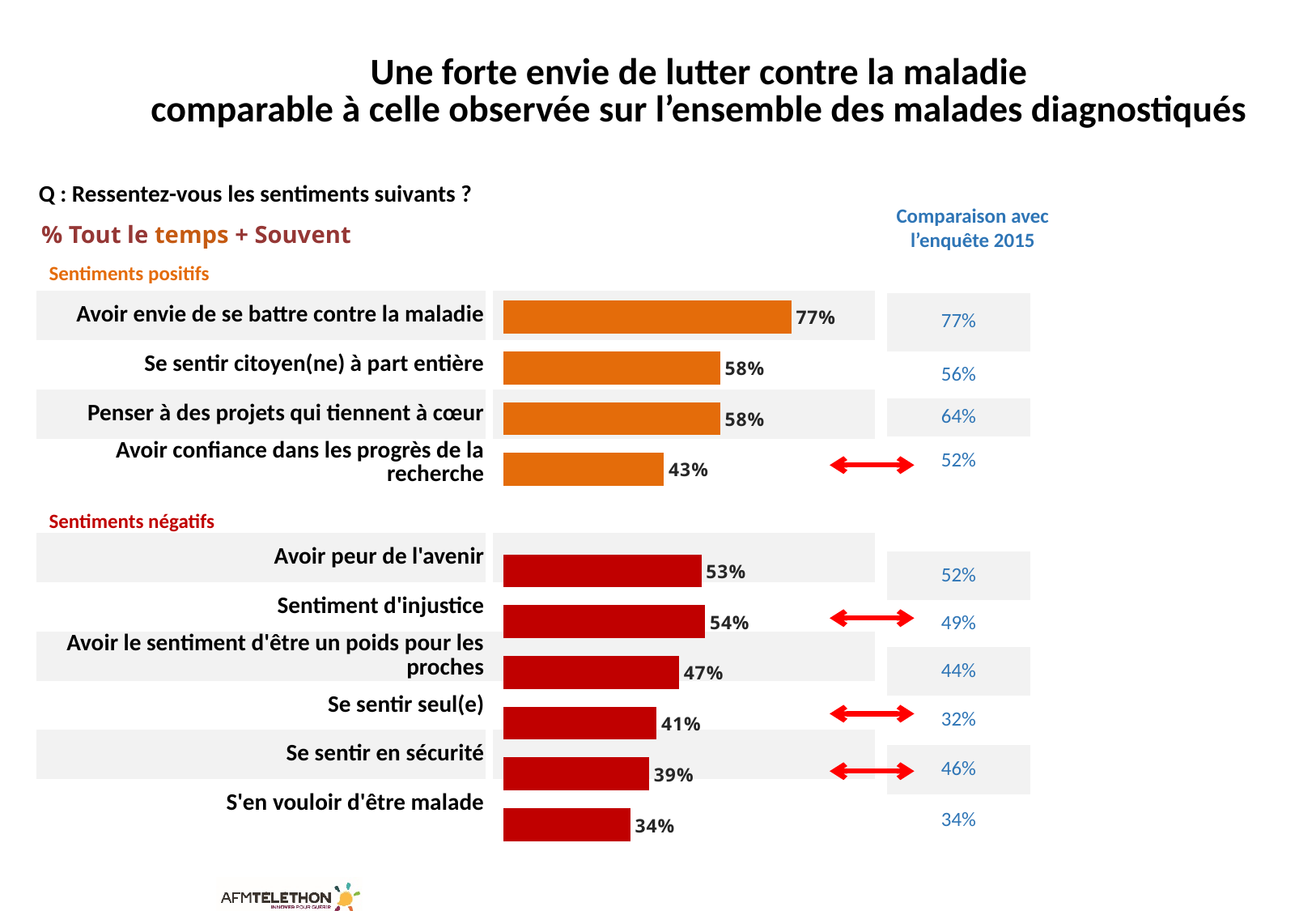
What is the difference between the percentage for "Se sentir en sécurité" and its 2015 comparison value? 7% Which category has the highest percentage in the bar chart? Avoir envie de se battre contre la maladie What colour are the bars for the "Sentiments négatifs" categories? Red What percentage is shown for "Se sentir seul(e)"? 41% What is the difference between the percentages for "Avoir envie de se battre contre la maladie" and "Se sentir citoyen(ne) à part entière"? 19% What kind of chart is shown on the slide? Bar chart What is the 2015 survey comparison value shown for "Se sentir seul(e)"? 32% What percentage is shown for "Avoir confiance dans les progrès de la recherche"? 43% Which is larger: the percentage for "Avoir peur de l'avenir" or for "Se sentir en sécurité"? Avoir peur de l'avenir What percentage is shown for "Avoir envie de se battre contre la maladie"? 77% Which category has the lowest percentage in the bar chart? S'en vouloir d'être malade How many categories are plotted in the bar chart? 10